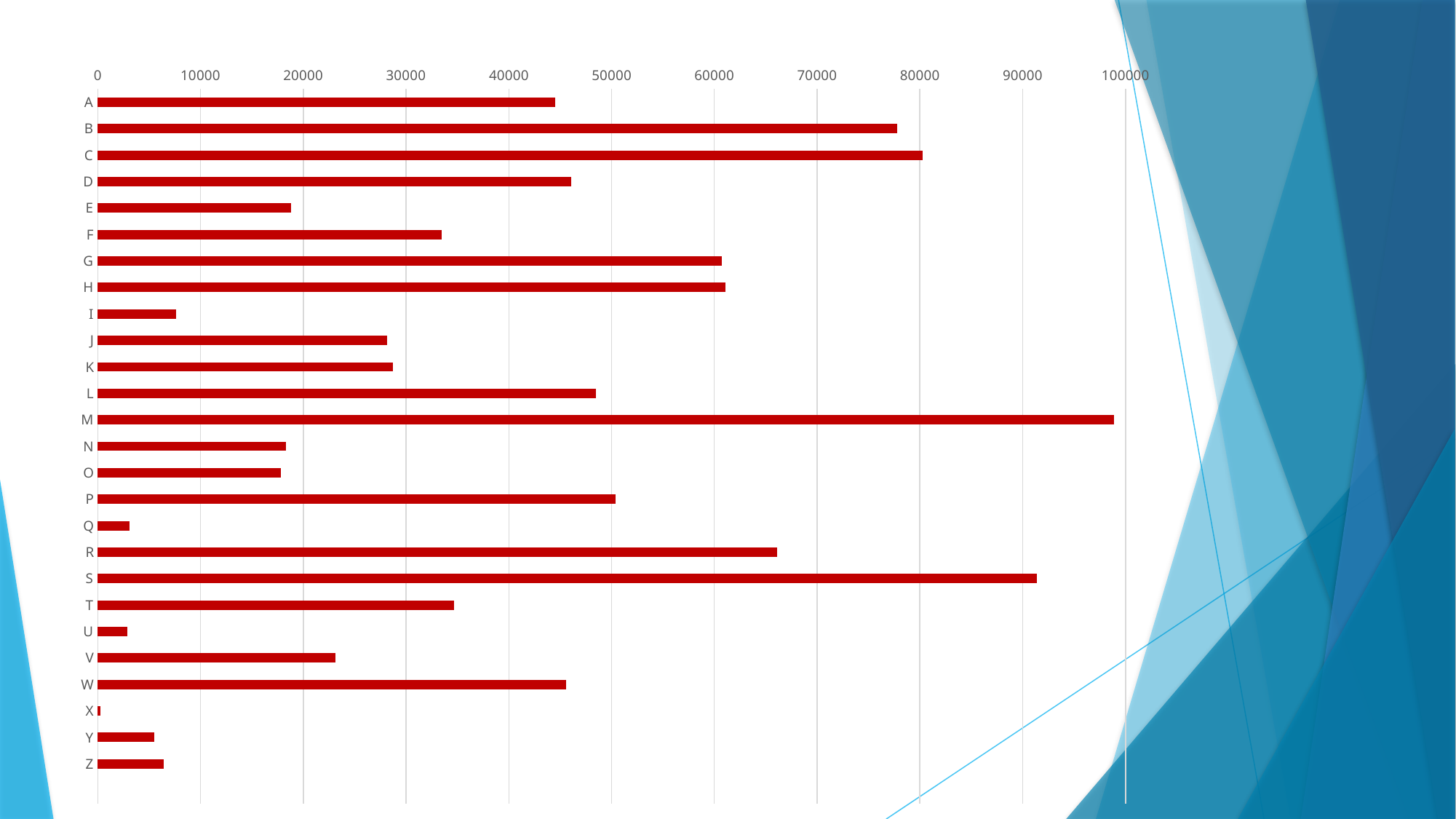
Which category has the lowest value? X Which category has the highest value? M What colour are the bars in the chart? red How many categories are plotted on the chart? 26 Is the value for M greater or less than 90000? greater What kind of chart is shown on the slide? bar chart Is the value for Q greater or less than 10000? less Is the value for R greater or less than 60000? greater Which has the larger value, C or A? C Which has the larger value, S or R? S